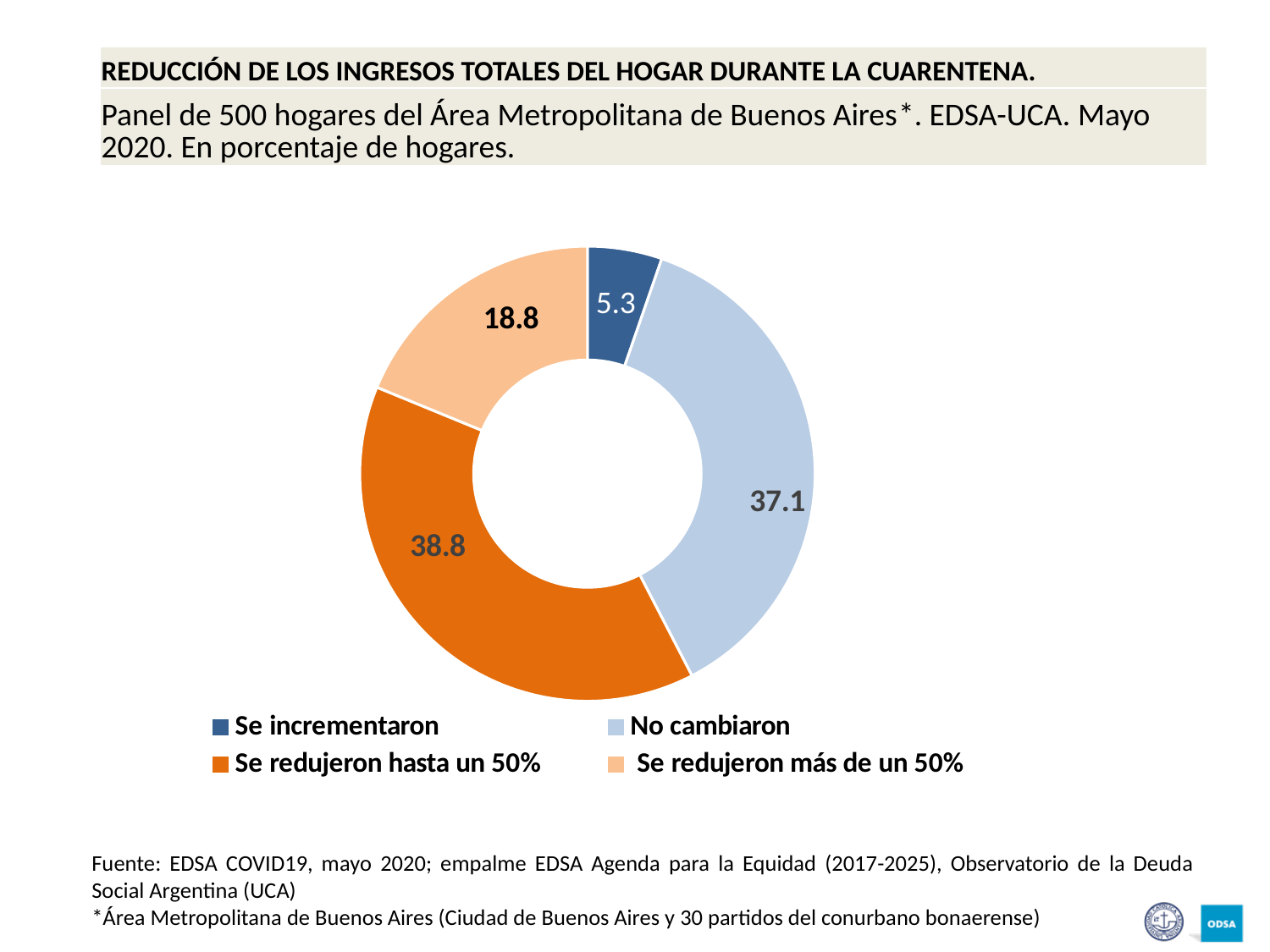
What is the value for 'Se redujeron hasta un 50%'? 38.8 Which category has the largest slice? Se redujeron hasta un 50% How many categories does the chart show? 4 What is the value for 'Se incrementaron'? 5.3 Which category has the smallest slice? Se incrementaron Which colour represents 'Se redujeron hasta un 50%' in the legend? Orange What is the combined value of the two 'Se redujeron' categories? 57.6 What is the difference between the values for 'Se redujeron hasta un 50%' and 'No cambiaron'? 1.7 What type of chart is shown on the slide? Doughnut (pie) chart What is the value for 'No cambiaron'? 37.1 What is the value for 'Se redujeron más de un 50%'? 18.8 Which is larger, the value for 'Se redujeron más de un 50%' or the value for 'Se incrementaron'? Se redujeron más de un 50%